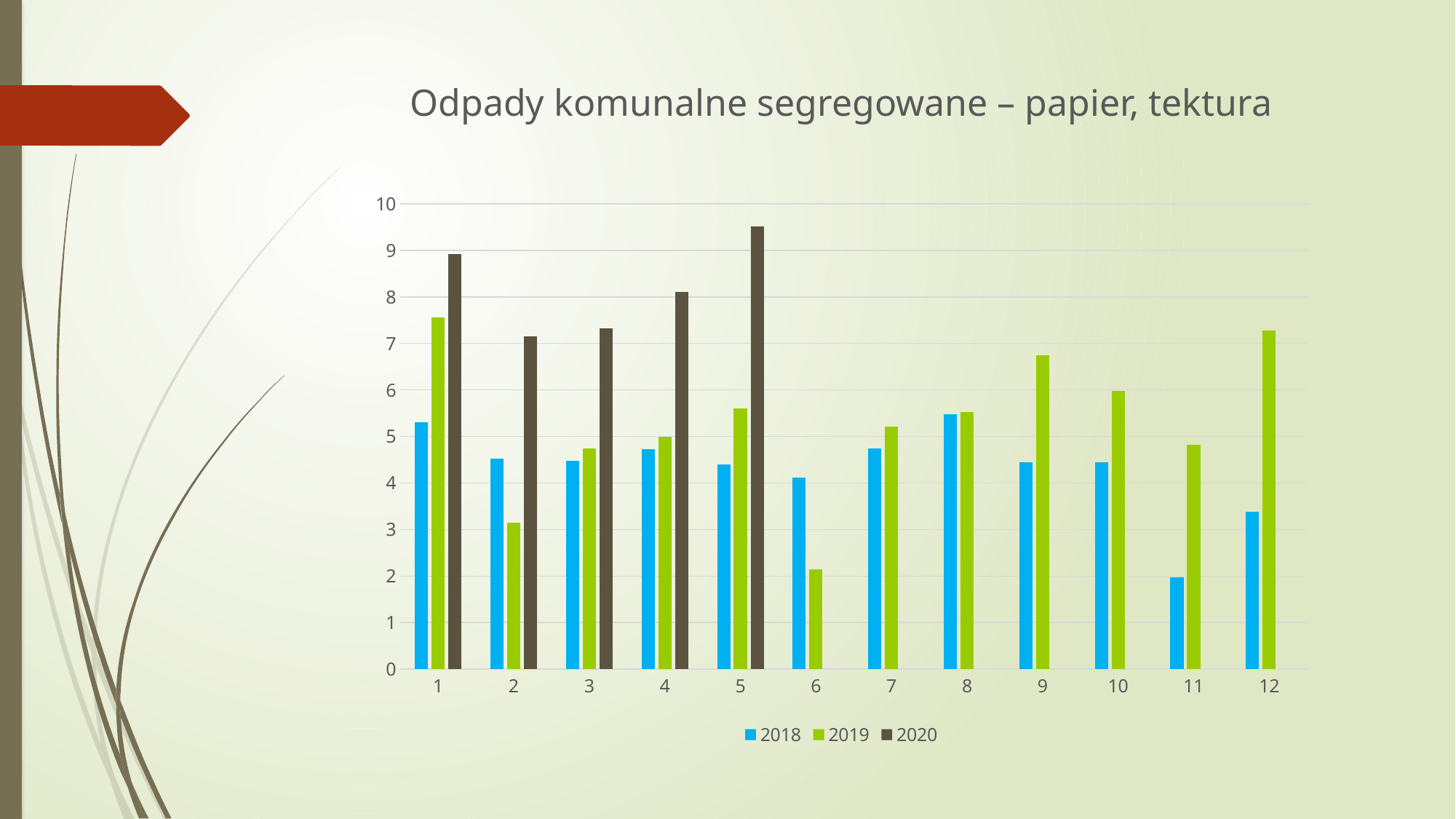
In which category is the 2019 value lowest? 6 Is the 2020 value for category 5 greater or less than 9? greater What is the title of the chart? Odpady komunalne segregowane – papier, tektura In category 2, which series has the larger value, 2018 or 2019? 2018 What kind of chart is shown on the slide? bar chart Is the 2019 value for category 6 greater or less than 3? less Is the 2019 value for category 9 greater or less than 6? greater In which category is the 2018 value lowest? 11 How many categories are shown on the x axis? 12 For how many categories is a 2020 bar plotted? 5 How many series does the legend list? 3 In which category is the 2020 value highest? 5